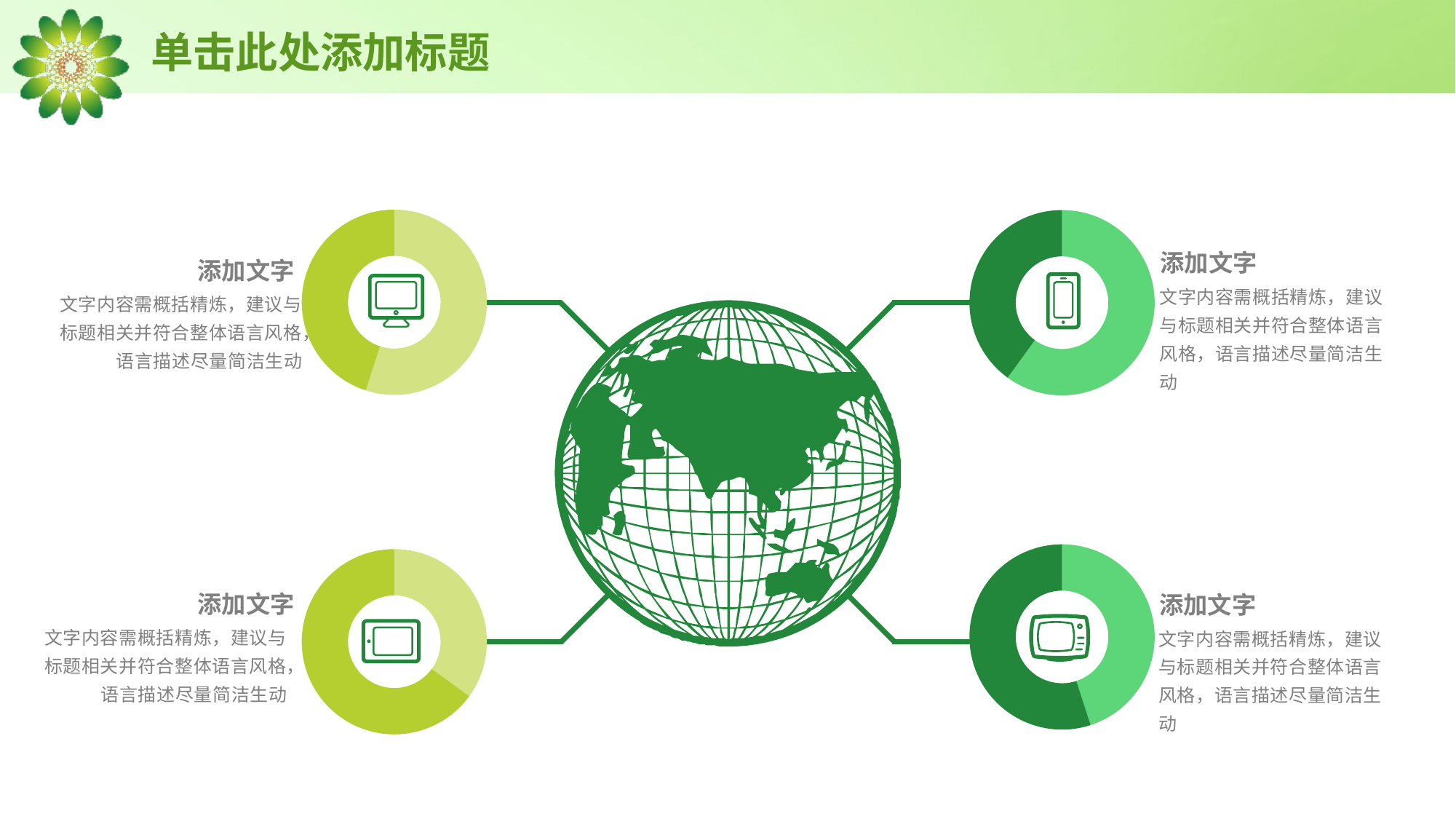
In the top-right donut chart, is the dark green slice or the light green slice larger? The light green slice Do any of the donut charts on the slide display data labels or a legend? No What kind of chart is shown at the top left of the slide? Donut (pie) chart In the bottom-left donut chart, is the lighter green slice or the darker green slice larger? The darker green slice How many slices does the top-left donut chart have? 2 What icon appears in the centre of the top-right donut chart? A mobile phone How many slices does the bottom-right donut chart have? 2 In the bottom-right donut chart, is the dark green slice or the light green slice larger? The dark green slice How many donut charts are on the slide? 4